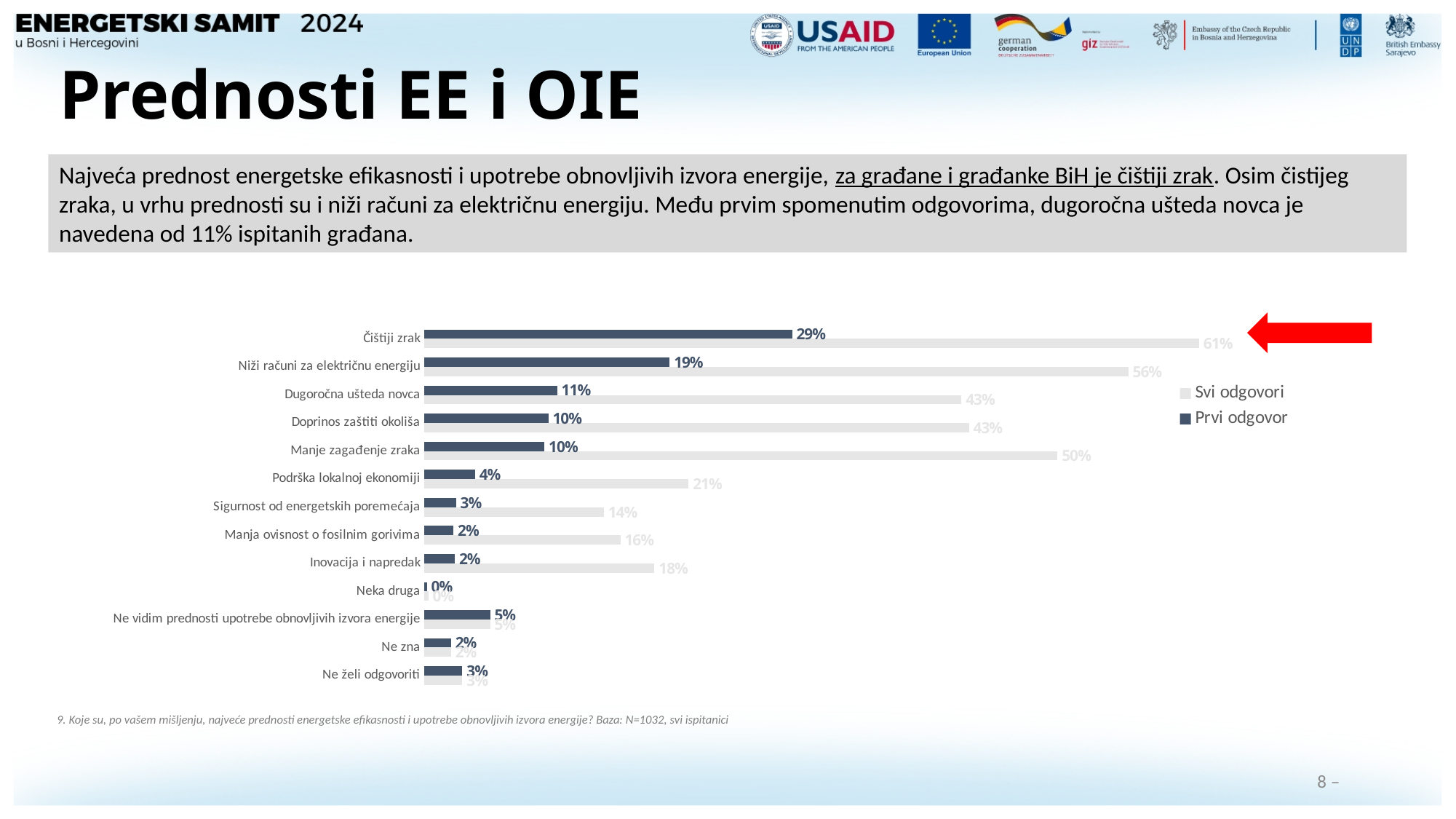
Which category has the lowest 'Svi odgovori' value? Neka druga What is the difference between the 'Prvi odgovor' values for 'Čistiji zrak' and 'Dugoročna ušteda novca'? 18% What is the difference between the 'Svi odgovori' and 'Prvi odgovor' values for 'Čistiji zrak'? 32% What is the 'Prvi odgovor' value for 'Niži računi za električnu energiju'? 19% What is the 'Svi odgovori' value for 'Čistiji zrak'? 61% How many categories are shown in the chart? 13 Which is larger: the 'Svi odgovori' value for 'Podrška lokalnoj ekonomiji' or for 'Inovacija i napredak'? Podrška lokalnoj ekonomiji How many series does the chart legend list? 2 What is the 'Svi odgovori' value for 'Manje zagađenje zraka'? 50% Which category has the highest 'Prvi odgovor' value? Čištiji zrak What are the two series named in the chart legend? Svi odgovori and Prvi odgovor What type of chart is shown on the slide? bar chart